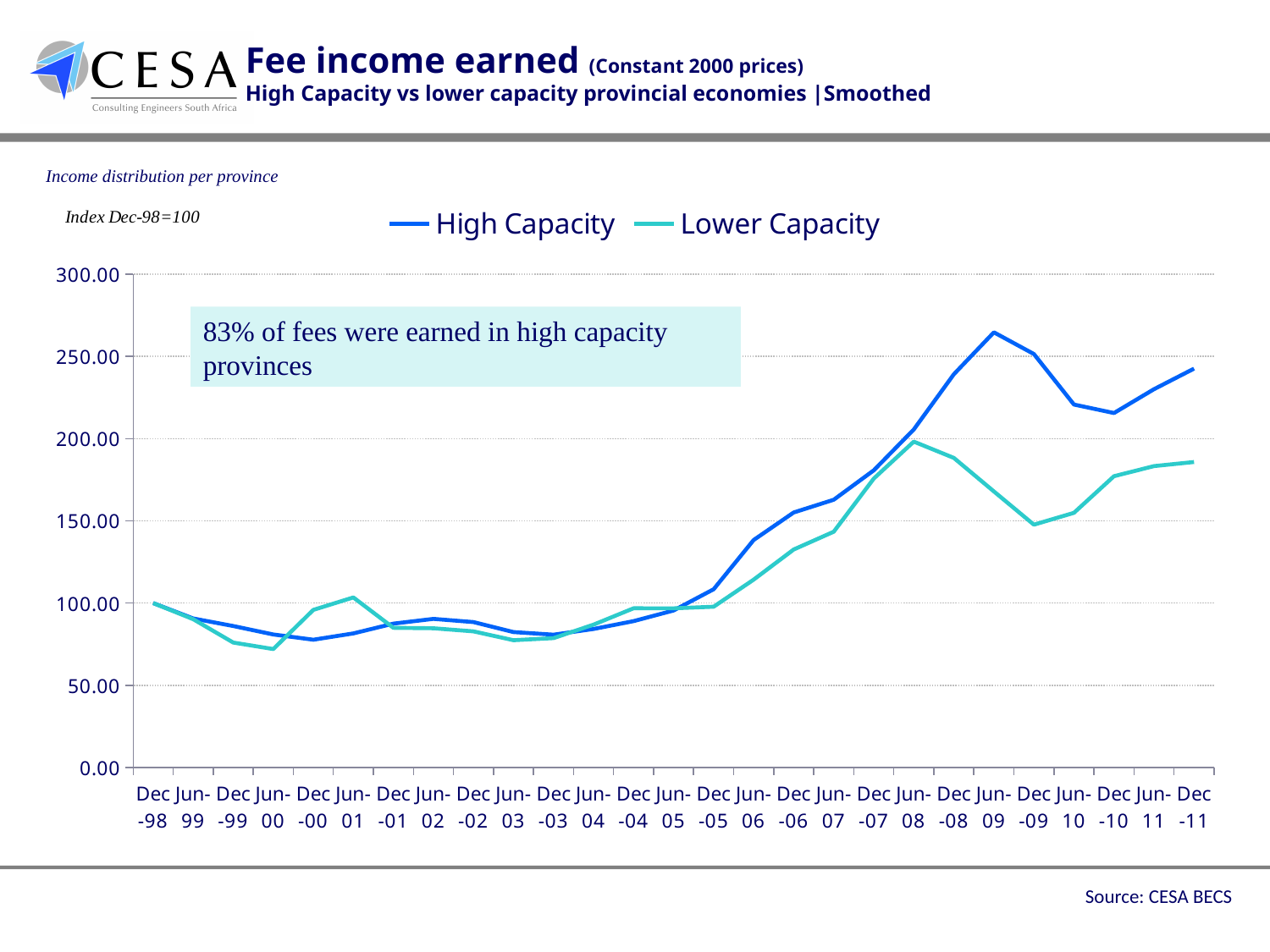
What are the two series named in the legend? High Capacity and Lower Capacity How many series does the legend list? 2 At which time point does the High Capacity series reach its highest value? Jun-09 Is the value for Lower Capacity at Jun-00 greater or less than 100? less How many time points are labelled along the x axis? 27 What kind of chart is shown on the slide? Line chart Does the High Capacity series rise or fall between Dec-05 and Jun-09? Rise Is the value for High Capacity at Dec-11 greater or less than 250? less At which time point does the Lower Capacity series reach its highest value? Jun-08 Is the value for High Capacity at Jun-09 greater or less than 250? greater At Dec-09, which series has the higher value, High Capacity or Lower Capacity? High Capacity